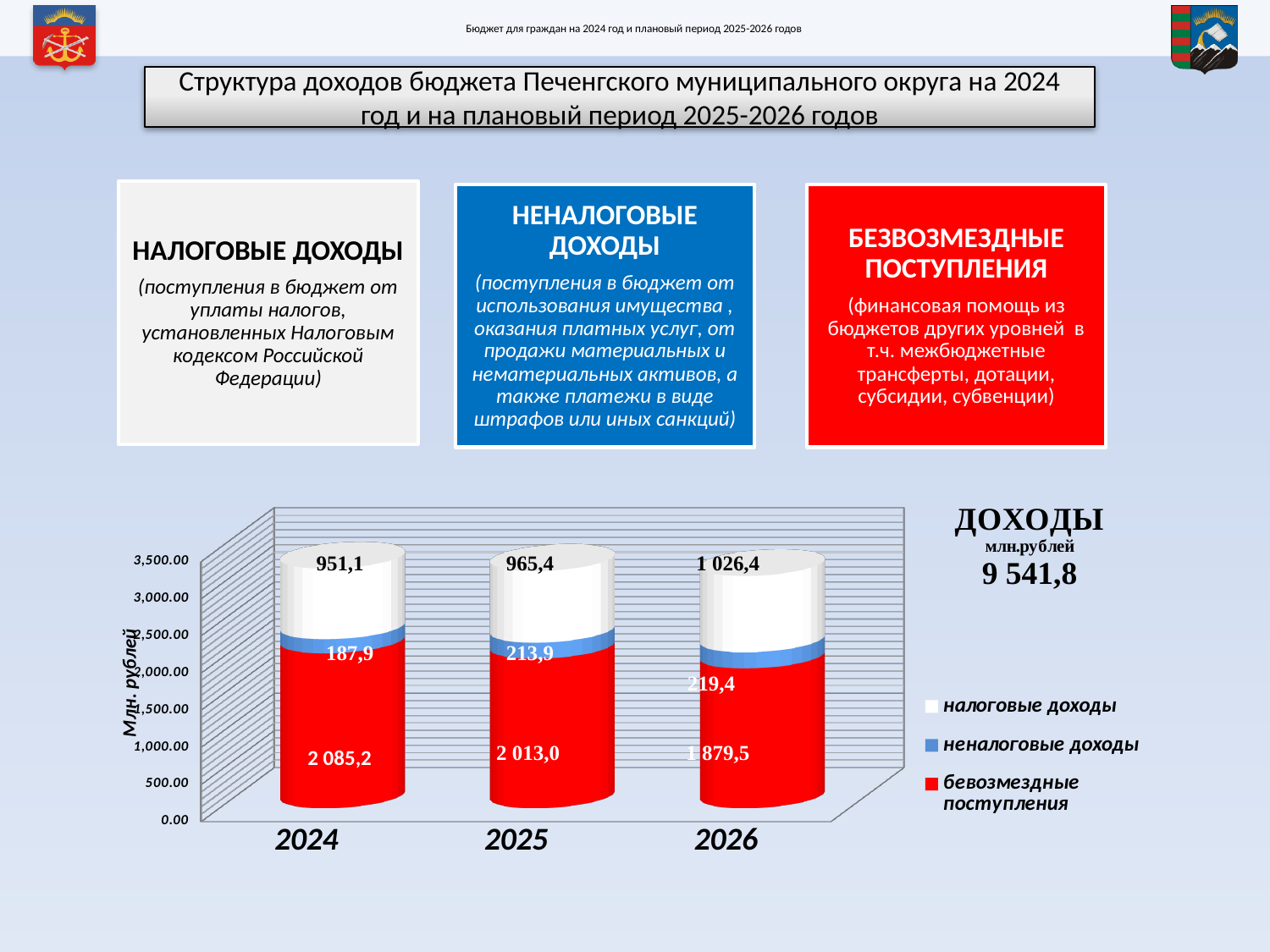
What is the value of безвозмездные поступления for 2026? 1 879,5 What kind of chart is shown on the slide? Stacked bar chart In which year is the value of налоговые доходы the highest? 2026 How many years are shown on the x axis of the chart? 3 What is the total of the stacked bar for 2024? 3 224,2 What is the difference between безвозмездные поступления in 2024 and in 2025? 72,2 How many series does the chart legend list? 3 In which year is the value of безвозмездные поступления the lowest? 2026 What is the value of неналоговые доходы for 2025? 213,9 Do the values of безвозмездные поступления rise or fall from 2024 to 2026? Fall Which is larger: неналоговые доходы in 2024 or in 2026? 2026 What is the value of налоговые доходы for 2024? 951,1